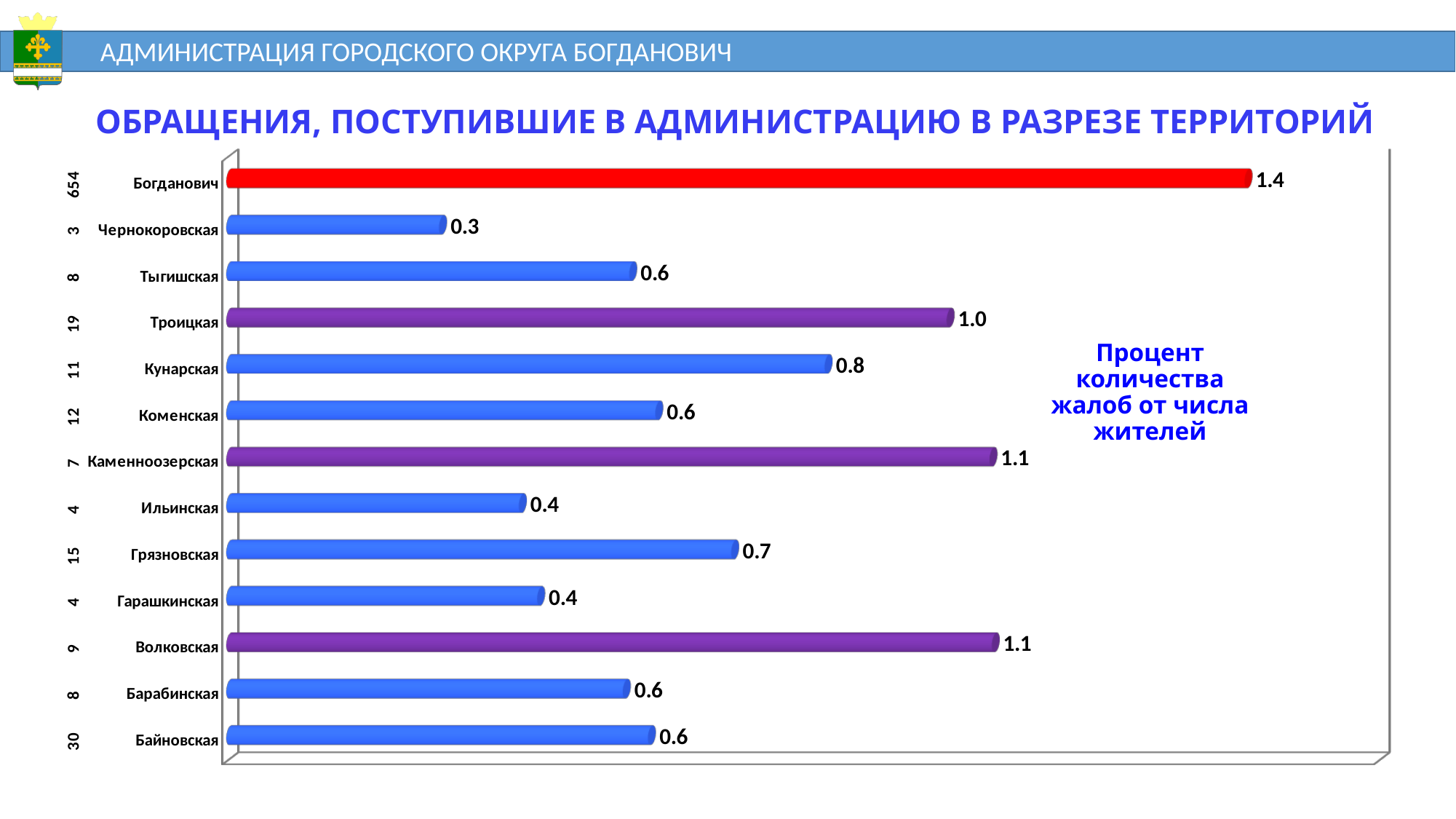
What is the value shown for Троицкая? 1.0 How many territories are shown in the chart? 13 What type of chart is shown on the slide? bar chart What colour is the bar for Богданович? red Which territory has the highest value in the chart? Богданович What is the difference between the values for Богданович and Чернокоровская? 1.1 What number is printed to the left of the Байновская label? 30 What is the value shown for Богданович? 1.4 What is the value shown for Кунарская? 0.8 What is the value shown for Грязновская? 0.7 Which territory has the lowest value in the chart? Чернокоровская Which has a larger value, Троицкая or Кунарская? Троицкая